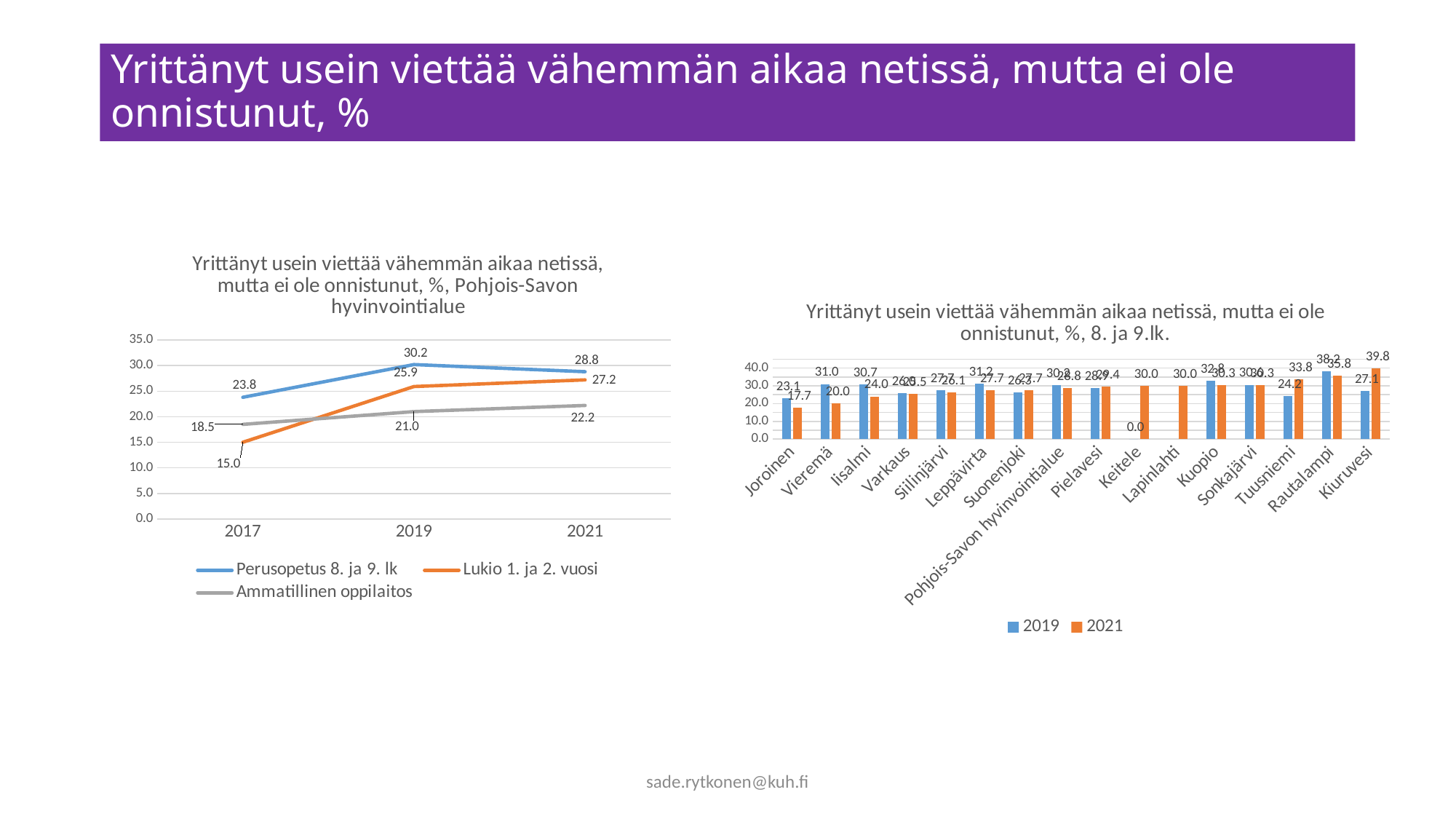
In the left chart (Pohjois-Savon hyvinvointialue), how many series does the legend list? 3 In the left chart (Pohjois-Savon hyvinvointialue), what is the value for Lukio 1. ja 2. vuosi in 2017? 15.0 In the right chart (8. ja 9.lk.), what is the 2019 value for Joroinen? 23.1 In the right chart (8. ja 9.lk.), what is the 2021 value for Kiuruvesi? 39.8 What kind of chart is the right chart, titled '8. ja 9.lk.'? bar chart In the left chart (Pohjois-Savon hyvinvointialue), what is the value for Ammatillinen oppilaitos in 2021? 22.2 In the right chart (8. ja 9.lk.), which municipality has the highest 2021 value? Kiuruvesi In the right chart (8. ja 9.lk.), how many categories are shown on the x axis? 16 In the left chart (Pohjois-Savon hyvinvointialue), does the Lukio 1. ja 2. vuosi line rise or fall from 2017 to 2021? rise In the left chart (Pohjois-Savon hyvinvointialue), what is the value for Perusopetus 8. ja 9. lk in 2019? 30.2 What kind of chart is the left chart, titled 'Pohjois-Savon hyvinvointialue'? line chart In the left chart (Pohjois-Savon hyvinvointialue), what is the difference between Perusopetus 8. ja 9. lk and Ammatillinen oppilaitos in 2017? 5.3